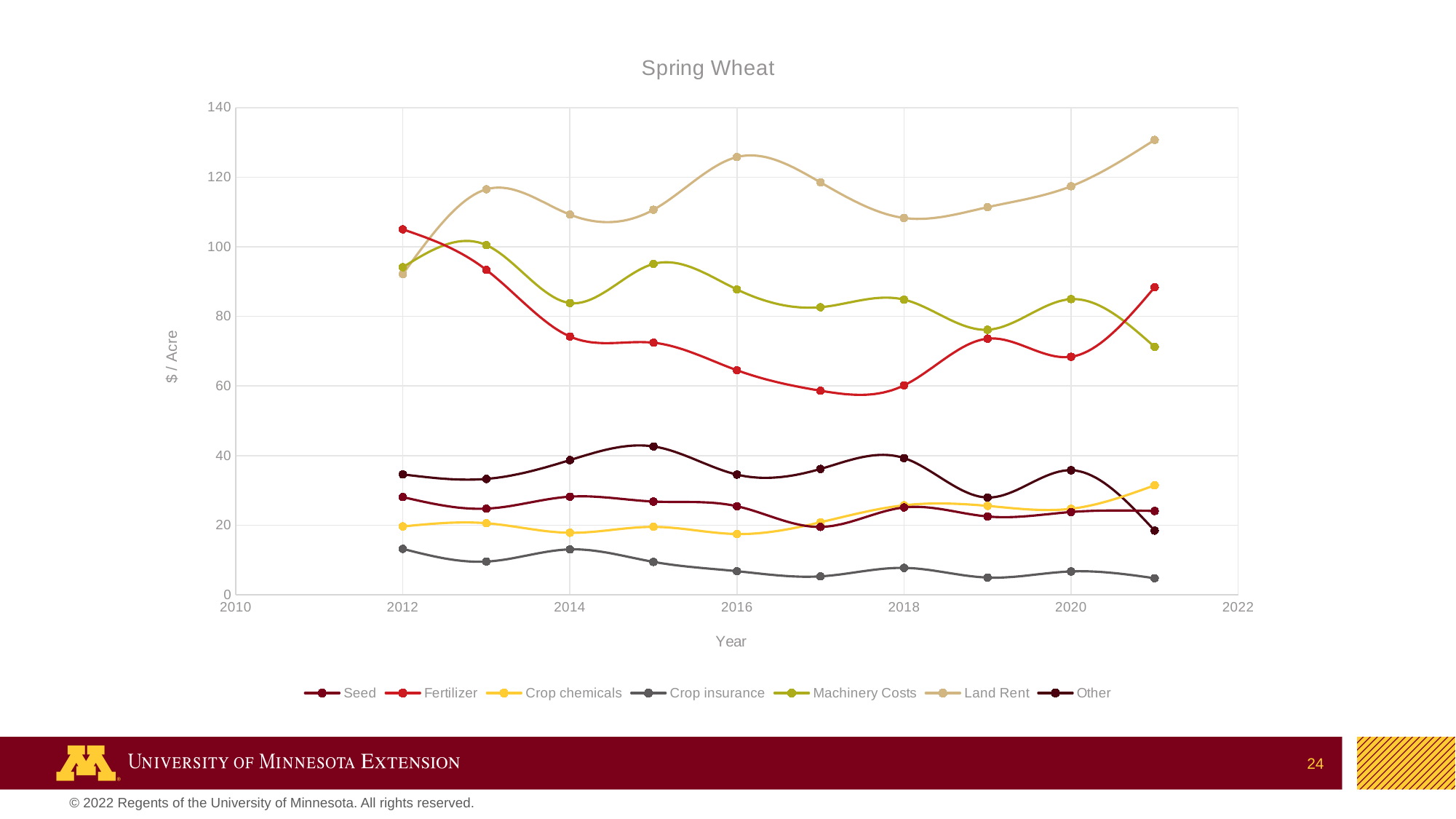
What is the title of the chart? Spring Wheat Which series has the lowest value in 2021? Crop insurance Is the value for Machinery Costs in 2021 greater or less than 80? less How many series does the legend list? 7 What is the label on the vertical axis? $ / Acre Is the value for Land Rent in 2021 greater or less than 120? greater In 2021, which is larger, Fertilizer or Machinery Costs? Fertilizer Is the value for Fertilizer in 2012 greater or less than 100? greater Which series has the highest value in 2021? Land Rent How many years of data are plotted for each series? 10 Does the Land Rent series rise or fall from 2018 to 2021? rise What kind of chart is shown on the slide? line chart